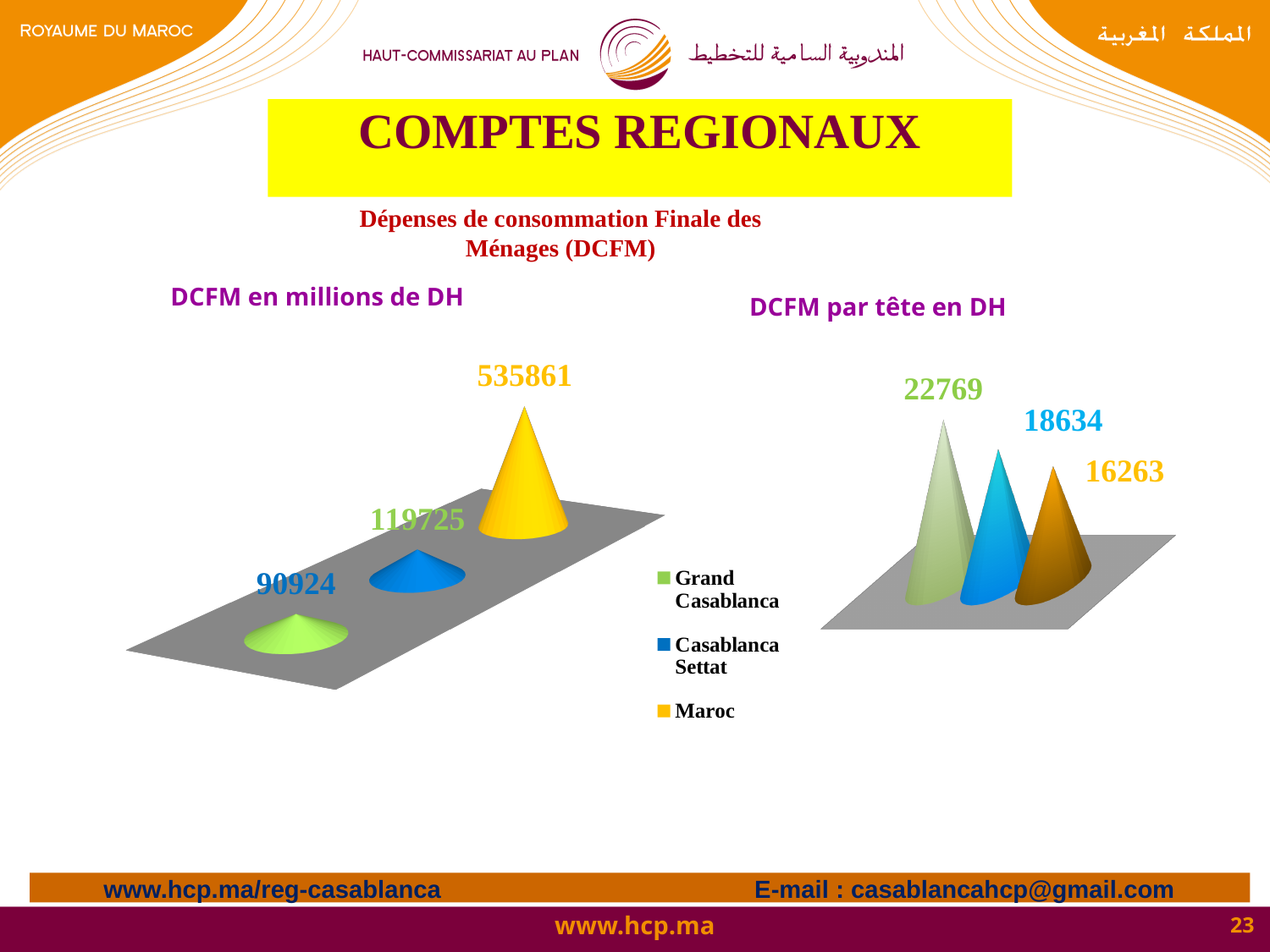
In the 'DCFM en millions de DH' chart, what is the value for Maroc? 535861 How many entries does the legend list for the charts on this slide? 3 In the 'DCFM par tête en DH' chart, which category has the highest value? Grand Casablanca In the 'DCFM en millions de DH' chart, which category has the highest value? Maroc In the 'DCFM par tête en DH' chart, what is the difference between the values for Grand Casablanca and Casablanca Settat? 4135 In the 'DCFM par tête en DH' chart, which is larger, the value for Casablanca Settat or the value for Maroc? Casablanca Settat In the 'DCFM en millions de DH' chart, what is the value for Casablanca Settat? 119725 In the 'DCFM par tête en DH' chart, what is the value for Grand Casablanca? 22769 In the 'DCFM par tête en DH' chart, what is the value for Maroc? 16263 In the 'DCFM en millions de DH' chart, what is the difference between the values for Casablanca Settat and Grand Casablanca? 28801 In the 'DCFM en millions de DH' chart, what is the value for Grand Casablanca? 90924 In the 'DCFM par tête en DH' chart, which category has the lowest value? Maroc